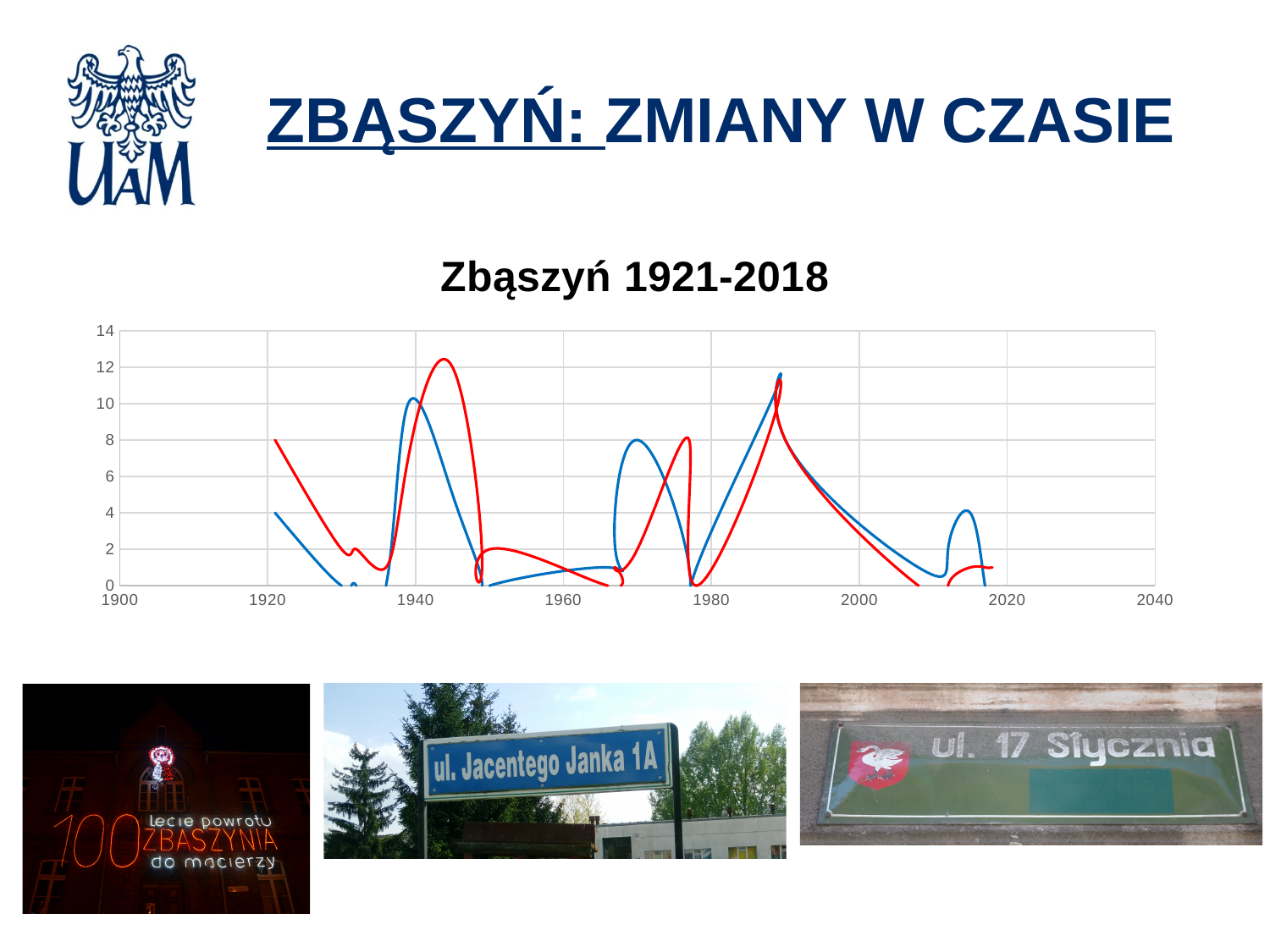
Between 1990 and 2010, do the values of the blue line rise or fall? fall Is the peak of the red line around 1944 greater or less than 10? greater Is the peak of the blue line around 1940 greater or less than 8? greater At the start of the series around 1921, which line has the higher value, the red or the blue? red How many lines are plotted on the chart? 2 Is the value of the red line around 1960 greater or less than 4? less What is the title of the chart? Zbąszyń 1921-2018 What is the highest value shown on the vertical axis of the chart? 14 What kind of chart is shown on the slide? line chart Around 1970, which line has the higher value, the blue or the red? blue